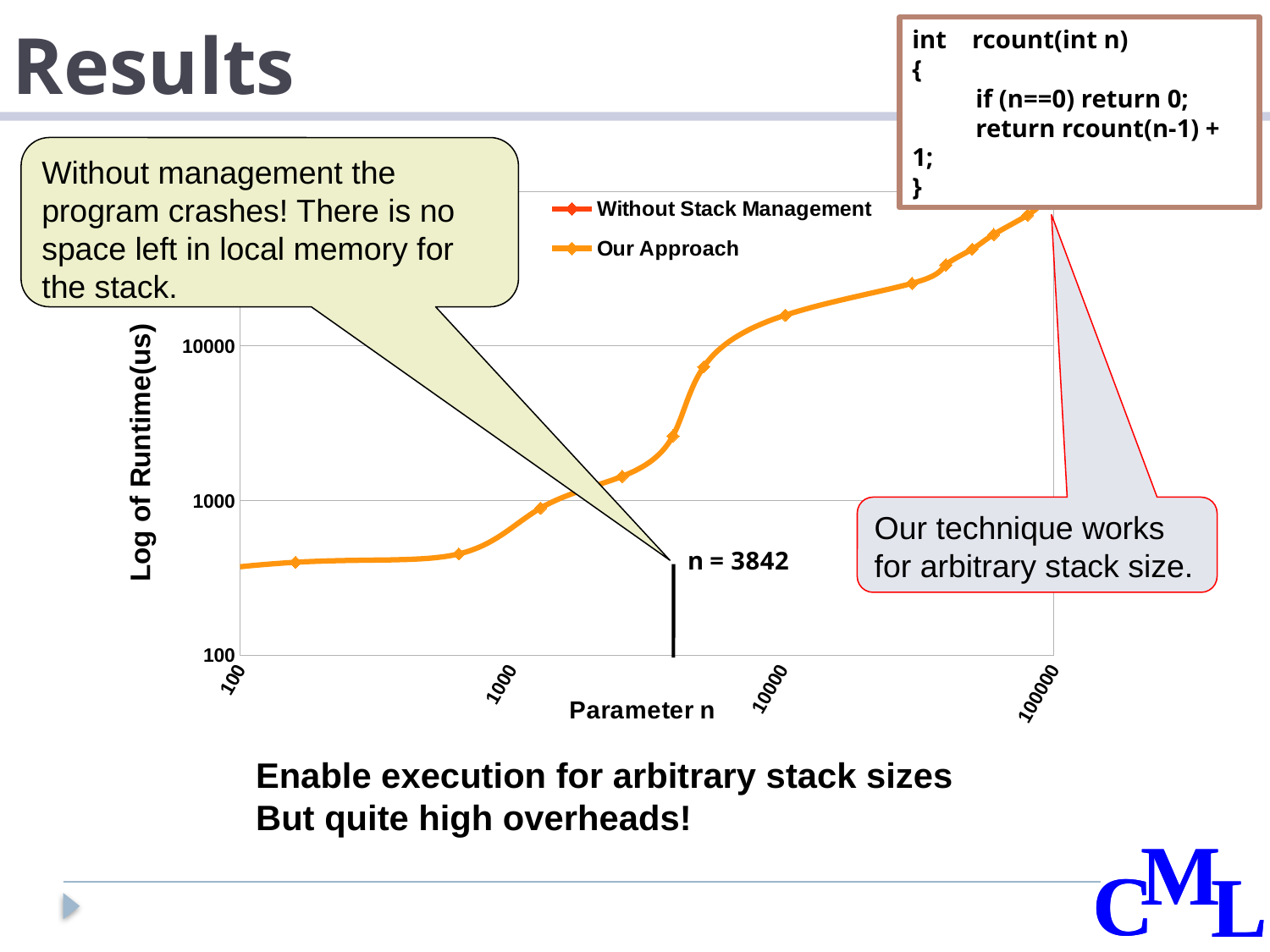
Is the runtime for Our Approach at n = 1000 greater or less than 1000? less What is the lowest value shown on the y axis of the chart? 100 What is the highest value shown on the x axis of the chart? 100000 Is the runtime for Our Approach at n = 100 greater or less than 1000? less Does the runtime for Our Approach rise or fall as Parameter n increases? rise What kind of chart is shown on the slide? line chart Is the runtime for Our Approach at n = 10000 greater or less than 10000? greater How many series does the chart legend list? 2 What are the two series named in the chart legend? Without Stack Management; Our Approach What is the label of the x axis of the chart? Parameter n What is the label of the y axis of the chart? Log of Runtime(us) At what value of n does the chart mark the point where the program without stack management crashes? n = 3842